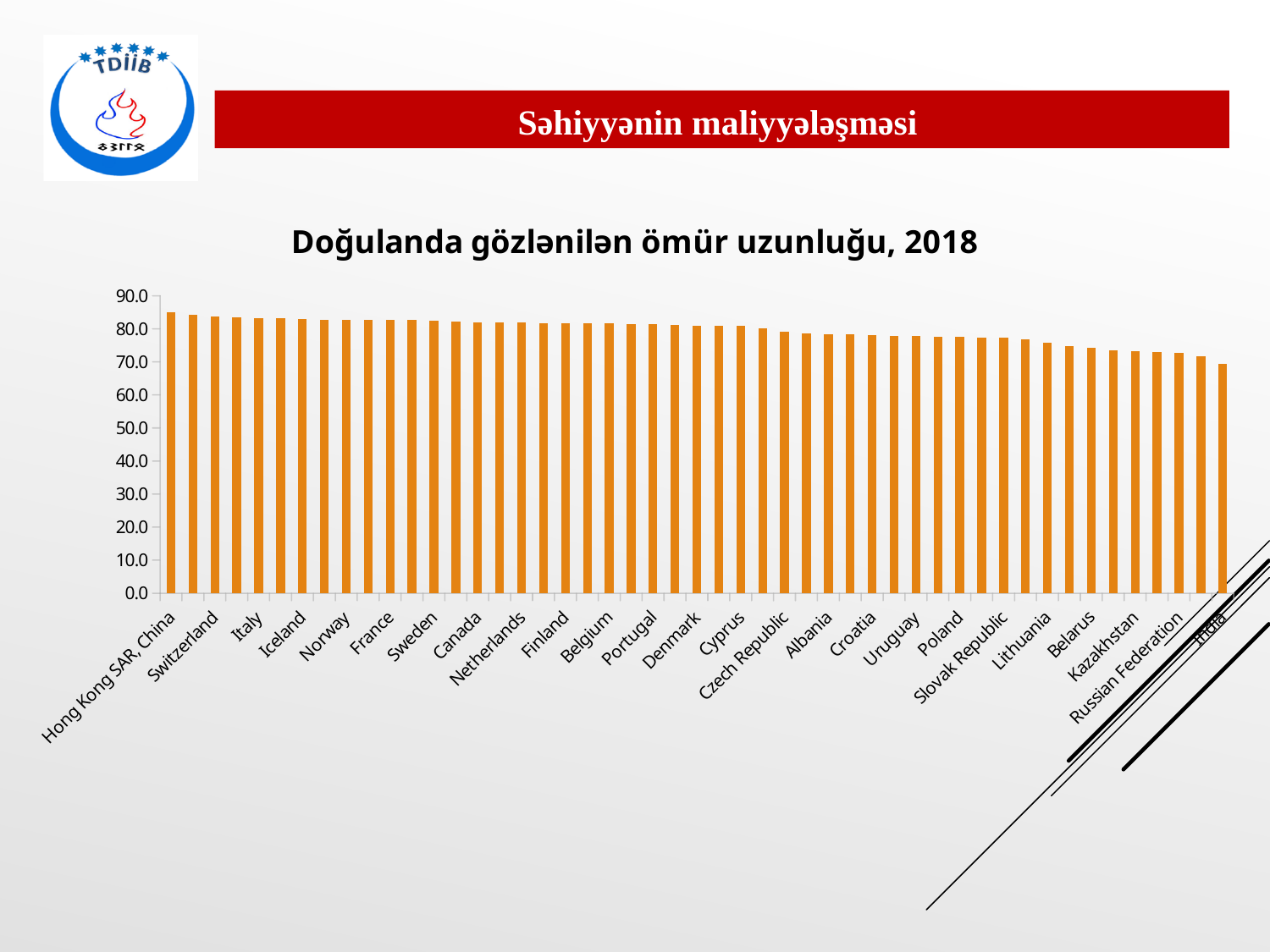
Which has the larger value, Norway or Lithuania? Norway Is the value for Hong Kong SAR, China greater or less than 80.0? greater Is the value for India greater or less than 80.0? less What is the title of the chart? Doğulanda gözlənilən ömür uzunluğu, 2018 Which labelled country has the highest value in the chart? Hong Kong SAR, China Do the values rise or fall moving from left to right along the x axis? fall What colour are the bars in the chart? orange Is the value for Switzerland greater or less than 80.0? greater Which labelled country has the lowest value in the chart? India Which has the larger value, Switzerland or Belarus? Switzerland What kind of chart is shown on the slide? bar chart